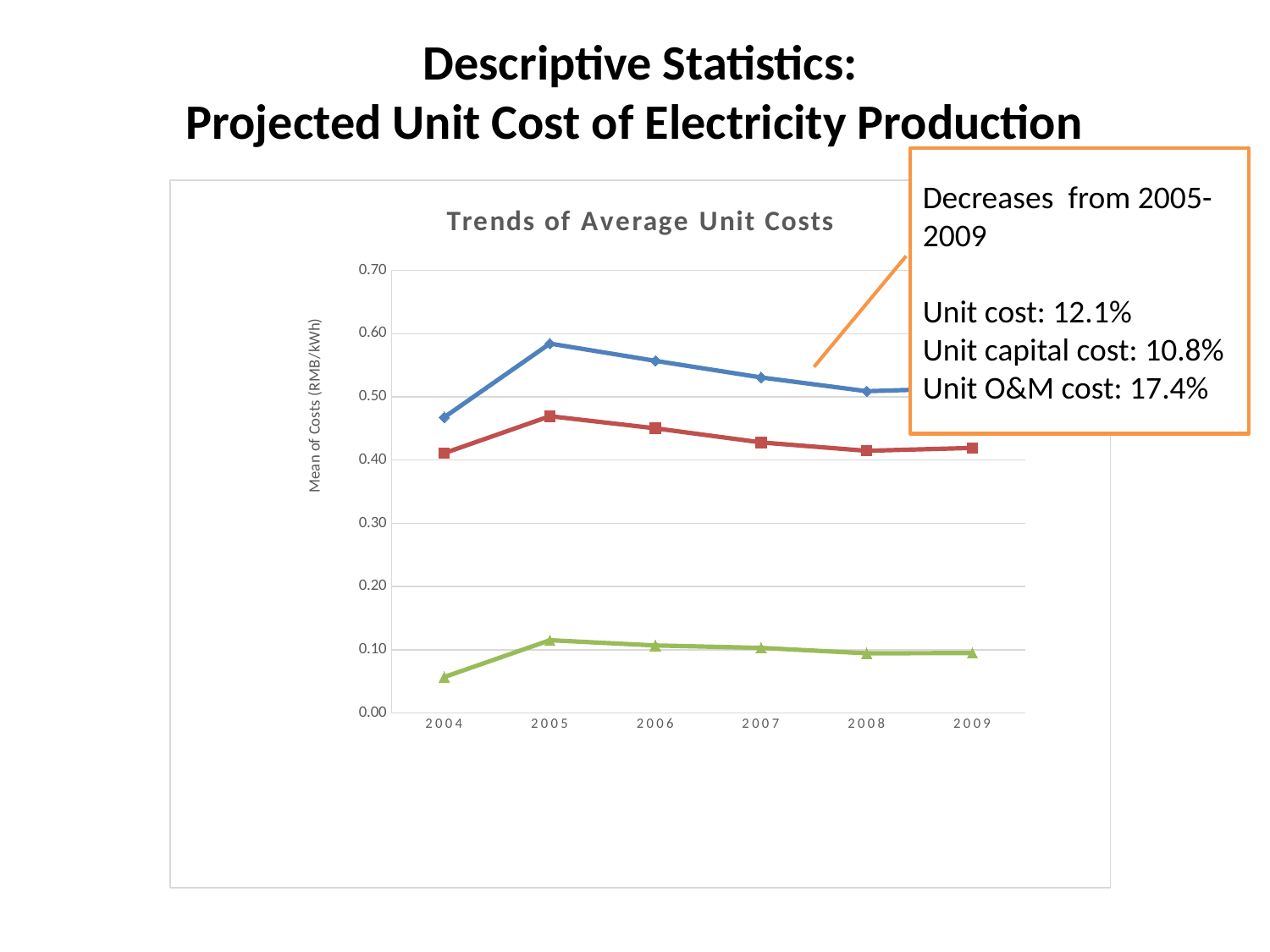
In which year does the green line reach its lowest value? 2004 What is the title of the chart? Trends of Average Unit Costs What kind of chart is shown on the slide? line chart How many years are shown along the x axis of the chart? 6 How many lines are plotted on the chart? 3 Is the value of the red line in 2005 greater or less than 0.50? less In which year does the blue line reach its highest value? 2005 Is the value of the green line in 2004 greater or less than 0.10? less Is the value of the blue line in 2005 greater or less than 0.50? greater What is the label on the vertical axis of the chart? Mean of Costs (RMB/kWh) Does the blue line rise or fall from 2005 to 2008? fall In which year does the red line reach its highest value? 2005